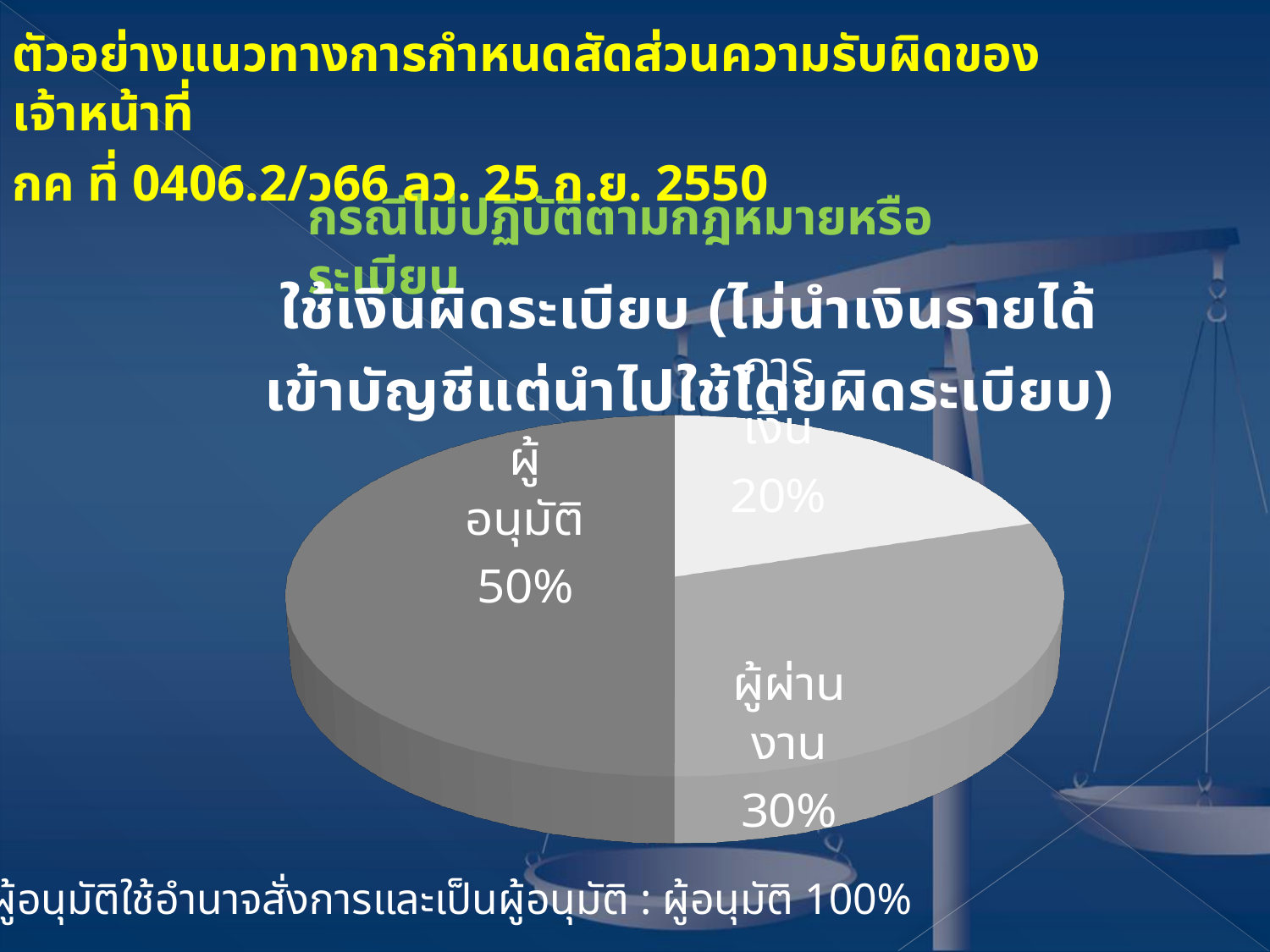
Which is larger in the pie chart, ผู้อนุมัติ or ผู้ผ่านงาน? ผู้อนุมัติ What kind of chart is shown on the slide? pie chart What is the title of the pie chart? ใช้เงินผิดระเบียบ (ไม่นำเงินรายได้เข้าบัญชีแต่นำไปใช้โดยผิดระเบียบ) What do the three slice percentages in the pie chart add up to? 100% What share of the pie does ผู้อนุมัติ account for? 50% Is the value for ผู้ผ่านงาน greater or less than 50%? less What percentage is shown for ผู้อนุมัติ in the pie chart? 50% How many slices does the pie chart have? 3 Which category has the largest slice of the pie chart? ผู้อนุมัติ What percentage is shown for ผู้ผ่านงาน in the pie chart? 30% What is the smallest percentage shown on any slice of the pie chart? 20% How many percentage points larger is the ผู้อนุมัติ slice than the ผู้ผ่านงาน slice? 20 percentage points